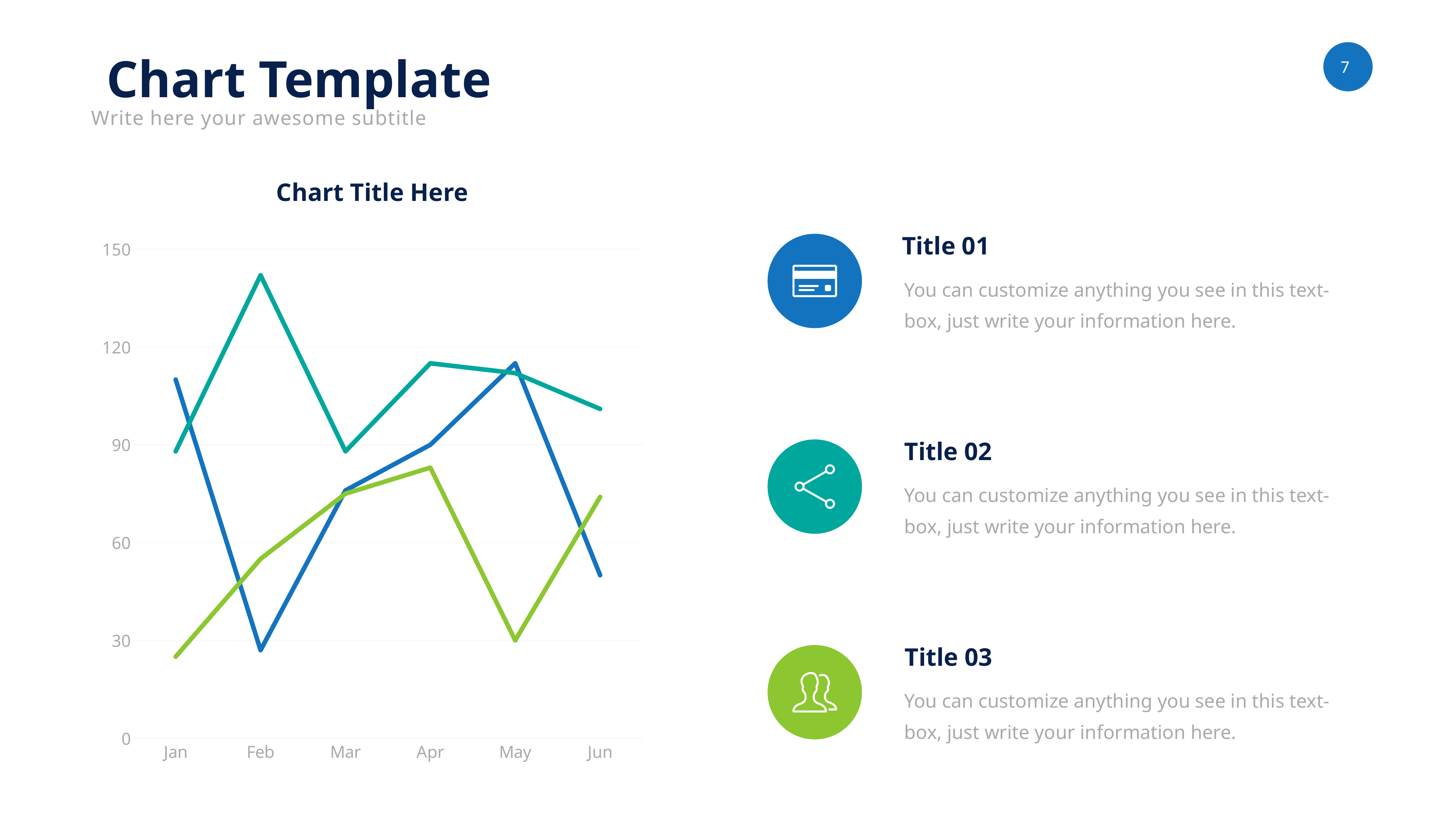
Does the green line rise or fall from Jan to Apr? rise In which month does the blue line reach its lowest value? Feb Is the value of the teal line in Feb greater or less than 120? greater In Jan, which line has the higher value, the blue line or the green line? blue line How many lines are plotted on the chart? 3 In which month does the teal line reach its highest value? Feb In May, which line has the higher value, the teal line or the green line? teal line How many months are shown on the x axis of the chart? 6 Is the value of the green line in May greater or less than 60? less Is the value of the blue line in Feb greater or less than 30? less What is the title of the chart? Chart Title Here What kind of chart is shown on the slide? line chart